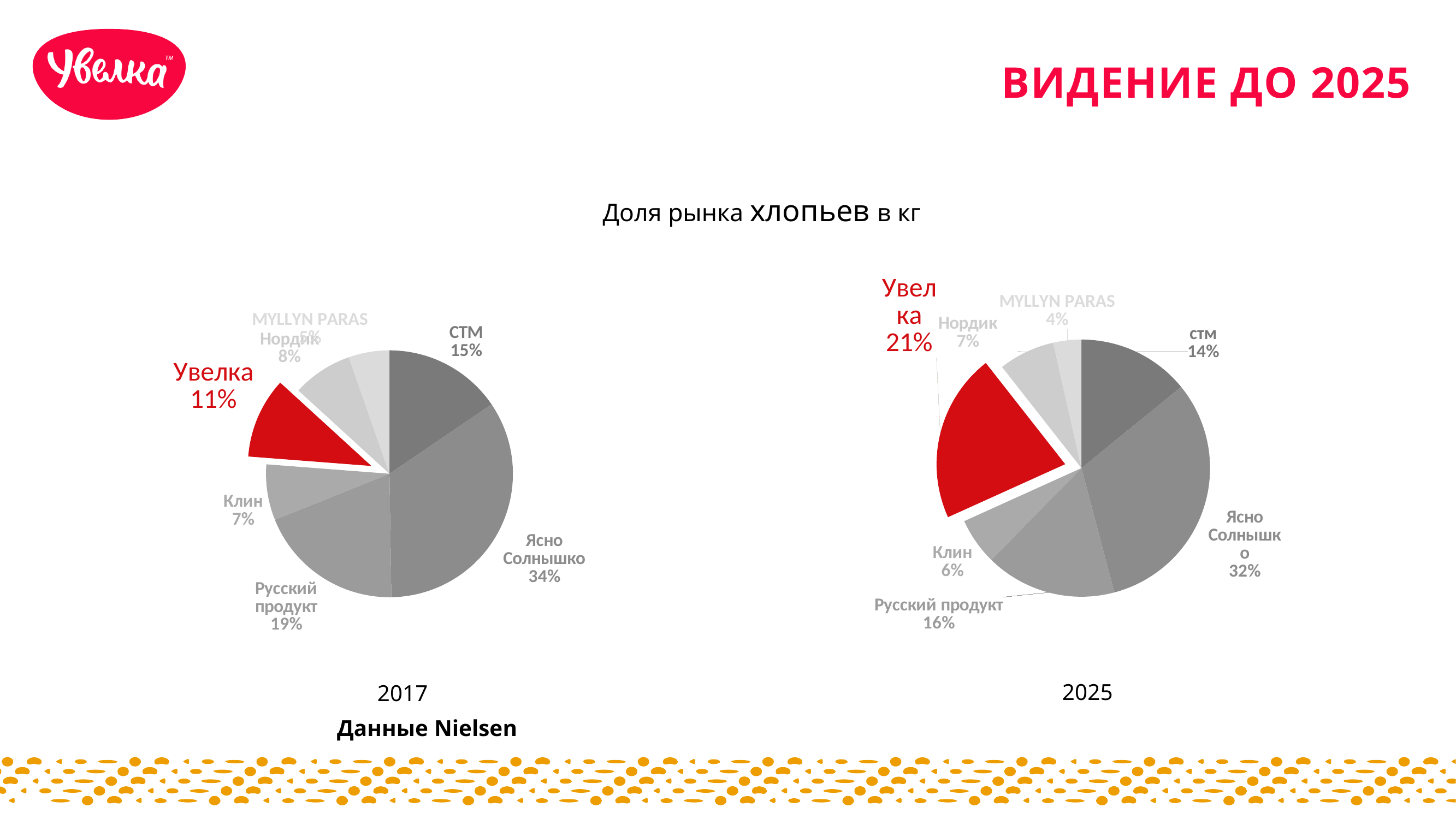
In the 2017 pie chart, what share does Ясно Солнышко hold? 34% What is the common title above the two charts? Доля рынка хлопьев в кг In the 2025 pie chart, what is the market share of Увелка? 21% What is the difference between Увелка's share in the 2025 chart and in the 2017 chart? 10 percentage points What type of chart is used for the 2017 data? Pie chart In the 2017 pie chart, which is larger: the share of СТМ or the share of Клин? СТМ In the 2017 pie chart, what is the market share of Увелка? 11% In the 2025 pie chart, what share does Русский продукт hold? 16% How many categories are shown in the 2025 pie chart? 7 In the 2025 pie chart, which category has the largest share? Ясно Солнышко In the 2025 pie chart, which category has the smallest share? MYLLYN PARAS In the 2017 pie chart, which category has the largest share? Ясно Солнышко